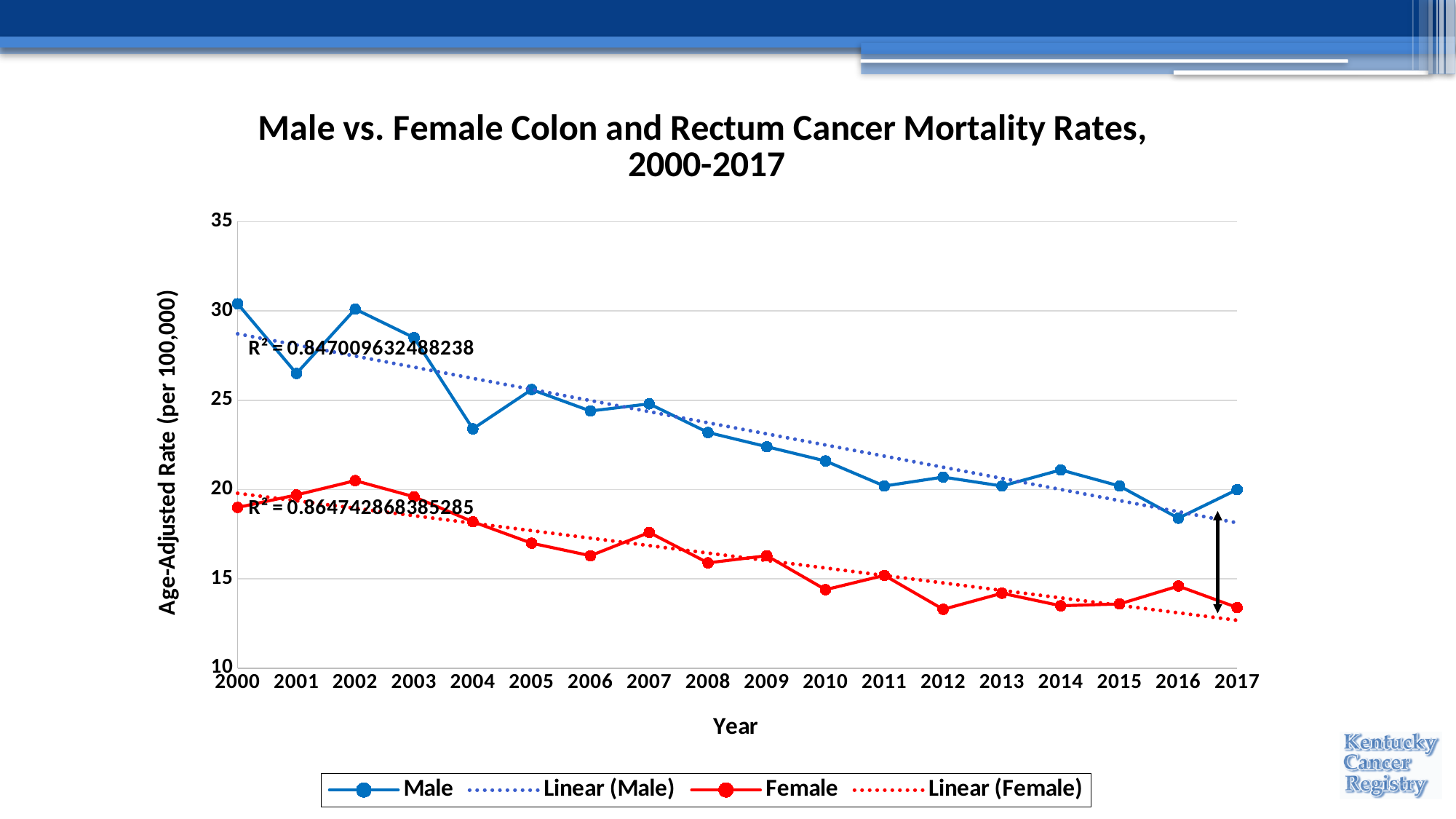
How many entries does the legend list? 4 What kind of chart is shown on the slide? line chart Is the Female value for 2012 greater or less than 15? less Do the Female mortality rates generally rise or fall from 2000 to 2017? fall In which year is the Male mortality rate lowest? 2016 Do the Male mortality rates generally rise or fall from 2000 to 2017? fall Is the Male value for 2004 greater or less than 25? less How many years are plotted along the x axis? 18 Is the Male value for 2016 greater or less than 20? less In 2017, which series has the higher value, Male or Female? Male In which year is the Female mortality rate highest? 2002